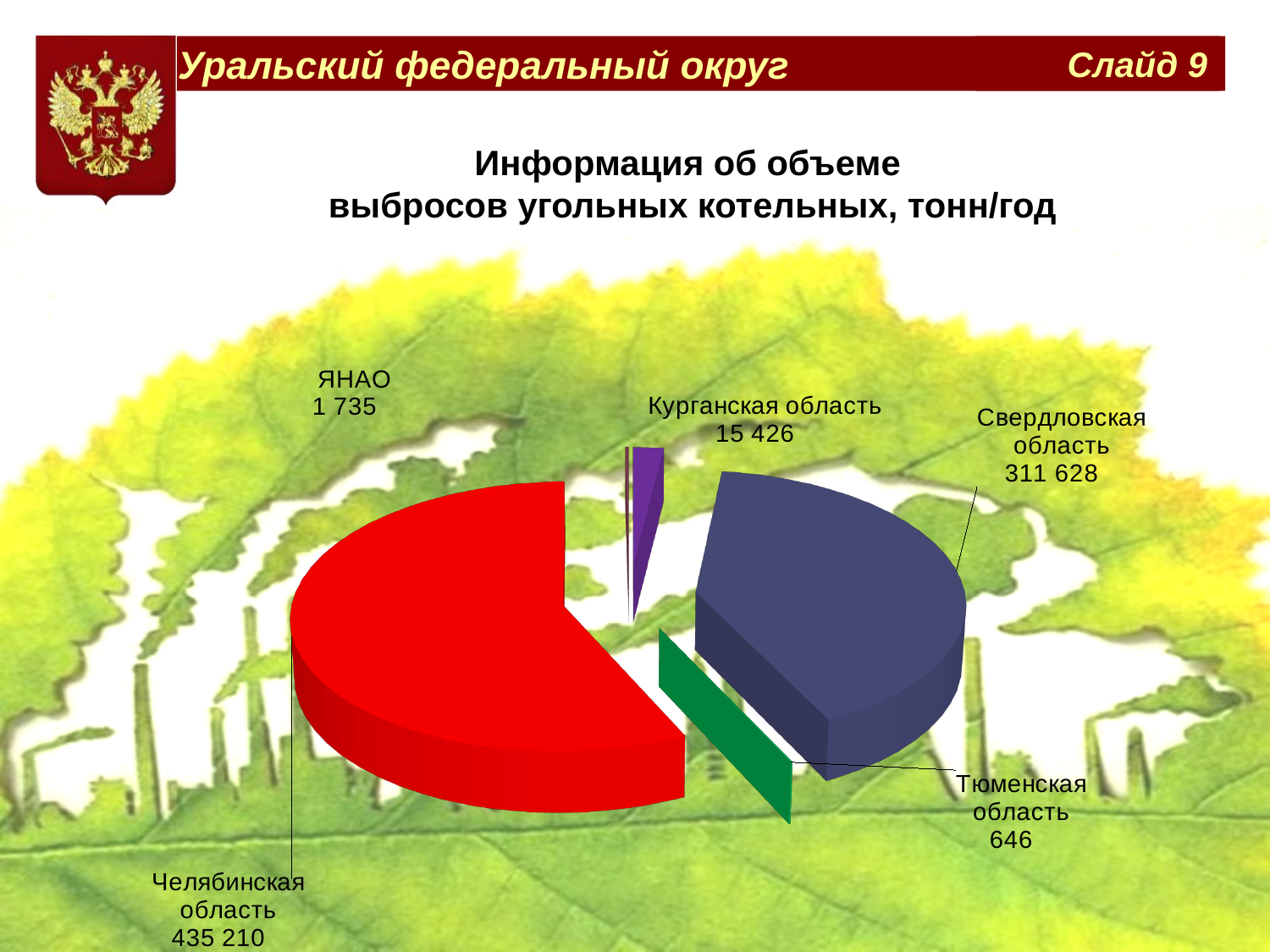
How many regions are shown in the pie chart? 5 What is the value for Свердловская область? 311 628 What type of chart is shown on the slide? Pie chart What is the value for Курганская область? 15 426 What is the title of the chart? Информация об объеме выбросов угольных котельных, тонн/год Which region has the largest volume of emissions? Челябинская область What is the value for Тюменская область? 646 What is the difference between the values for Челябинская область and Свердловская область? 123 582 Which region has the smallest volume of emissions? Тюменская область What is the value for ЯНАО? 1 735 Which is larger, the value for Курганская область or the value for ЯНАО? Курганская область What is the value for Челябинская область? 435 210